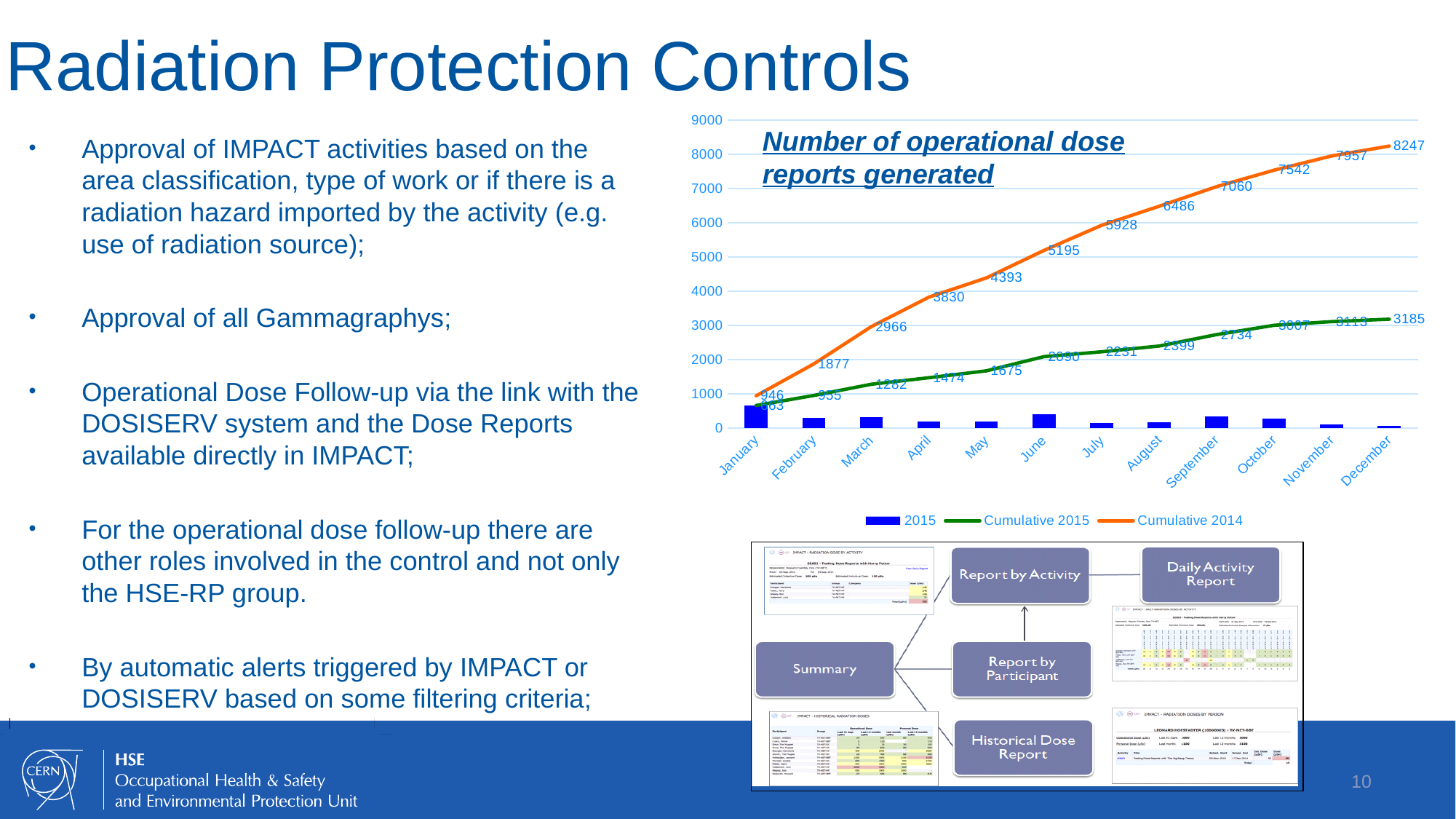
What is the Cumulative 2015 value for December? 3185 What is the title of the chart? Number of operational dose reports generated What kind of chart is shown on the slide? bar and line chart How many months are shown on the x axis of the chart? 12 What is the Cumulative 2014 value for June? 5195 Which month has the highest 2015 bar? January How many series does the chart legend list? 3 What is the Cumulative 2014 value for January? 946 What is the difference between the Cumulative 2014 and Cumulative 2015 values for December? 5062 What is the Cumulative 2015 value for March? 1282 Which is larger in December, the Cumulative 2014 value or the Cumulative 2015 value? Cumulative 2014 What is the Cumulative 2014 value for December? 8247